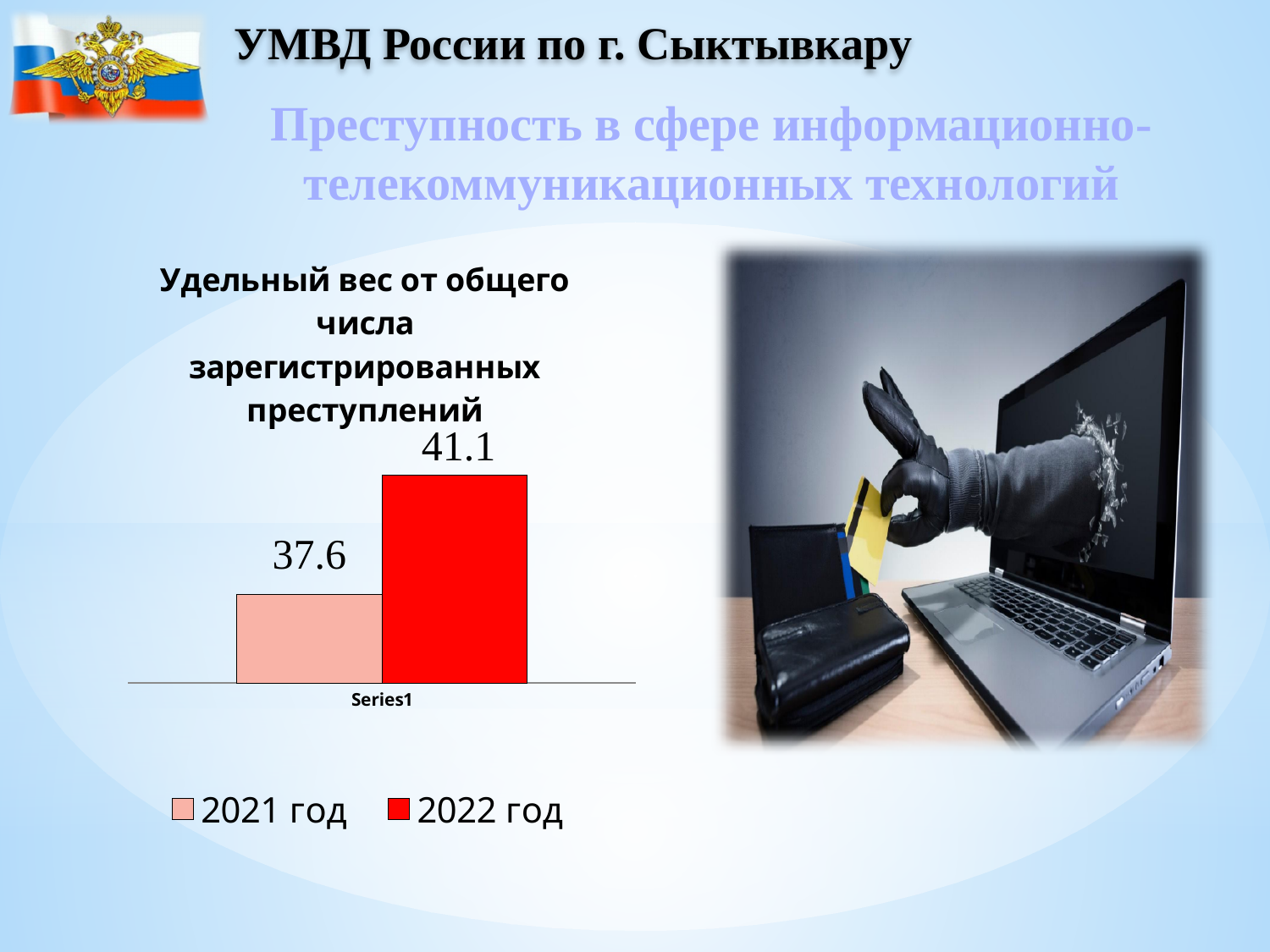
What is the category label shown on the x axis? Series1 What is the value for 2021 год in the chart? 37.6 Did the value rise or fall from 2021 год to 2022 год? rise What is the value for 2022 год in the chart? 41.1 How many series does the legend list? 2 Is the value for 2022 год larger or smaller than the value for 2021 год? larger Which year has the lower value in the chart? 2021 год What is the title of the chart? Удельный вес от общего числа зарегистрированных преступлений Which year has the higher value in the chart? 2022 год What is the difference between the 2022 год and 2021 год values? 3.5 What kind of chart is shown on the slide? bar chart What colour is the bar for 2022 год? red